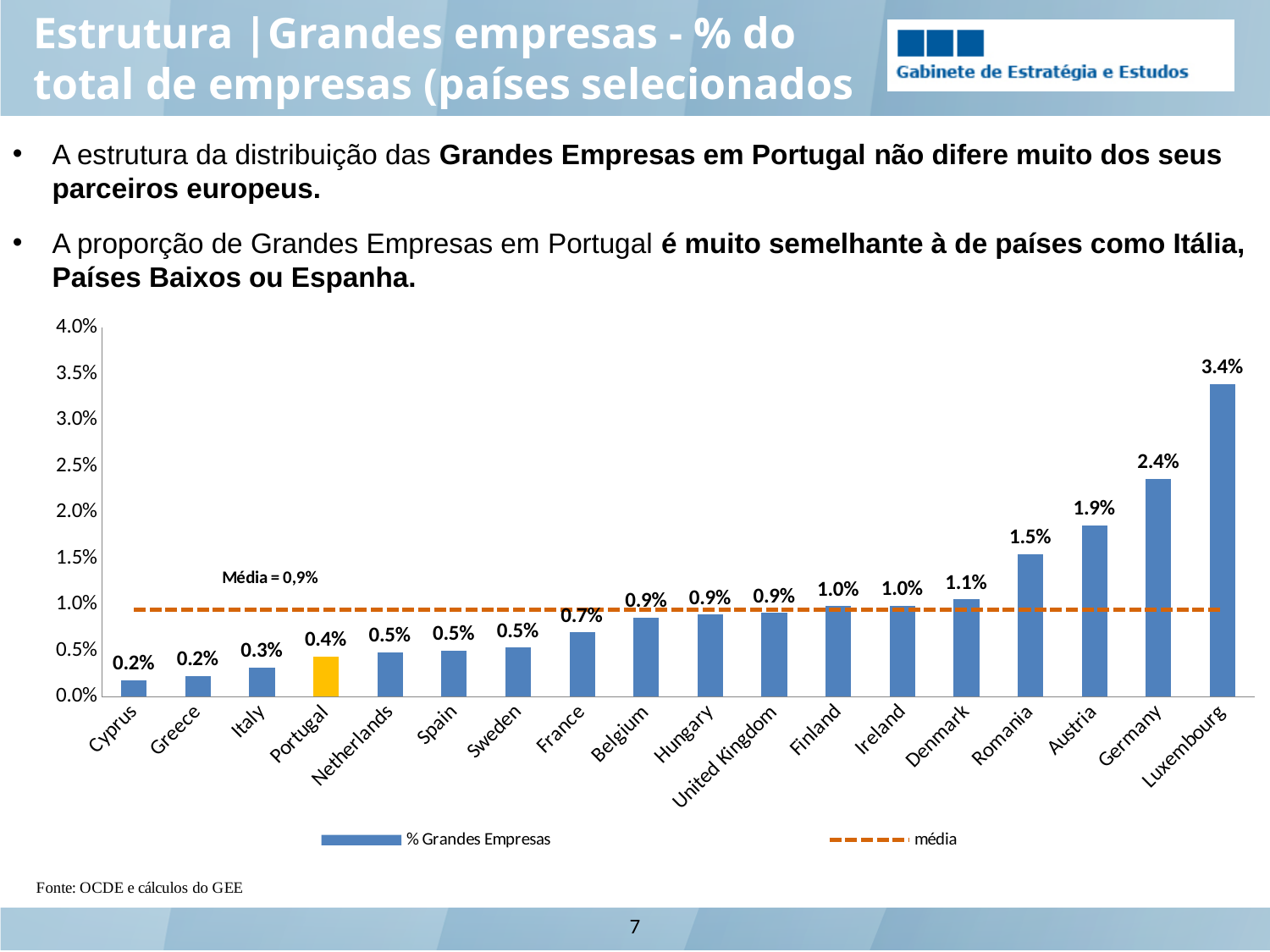
What is the value for Portugal? 0.4% What is the difference between the values for Luxembourg and Germany? 1.0% Which country has the highest value? Luxembourg What is the value for Romania? 1.5% What kind of chart is shown? bar chart Which is larger, the value for Denmark or the value for France? Denmark What is the value of the average (Média) shown by the dashed line? 0,9% Is the value for Austria greater or less than 1.5%? greater What is the value for Germany? 2.4% How many series does the legend list? 2 What is the difference between the values for Austria and Portugal? 1.5% How many countries are shown on the x axis? 18